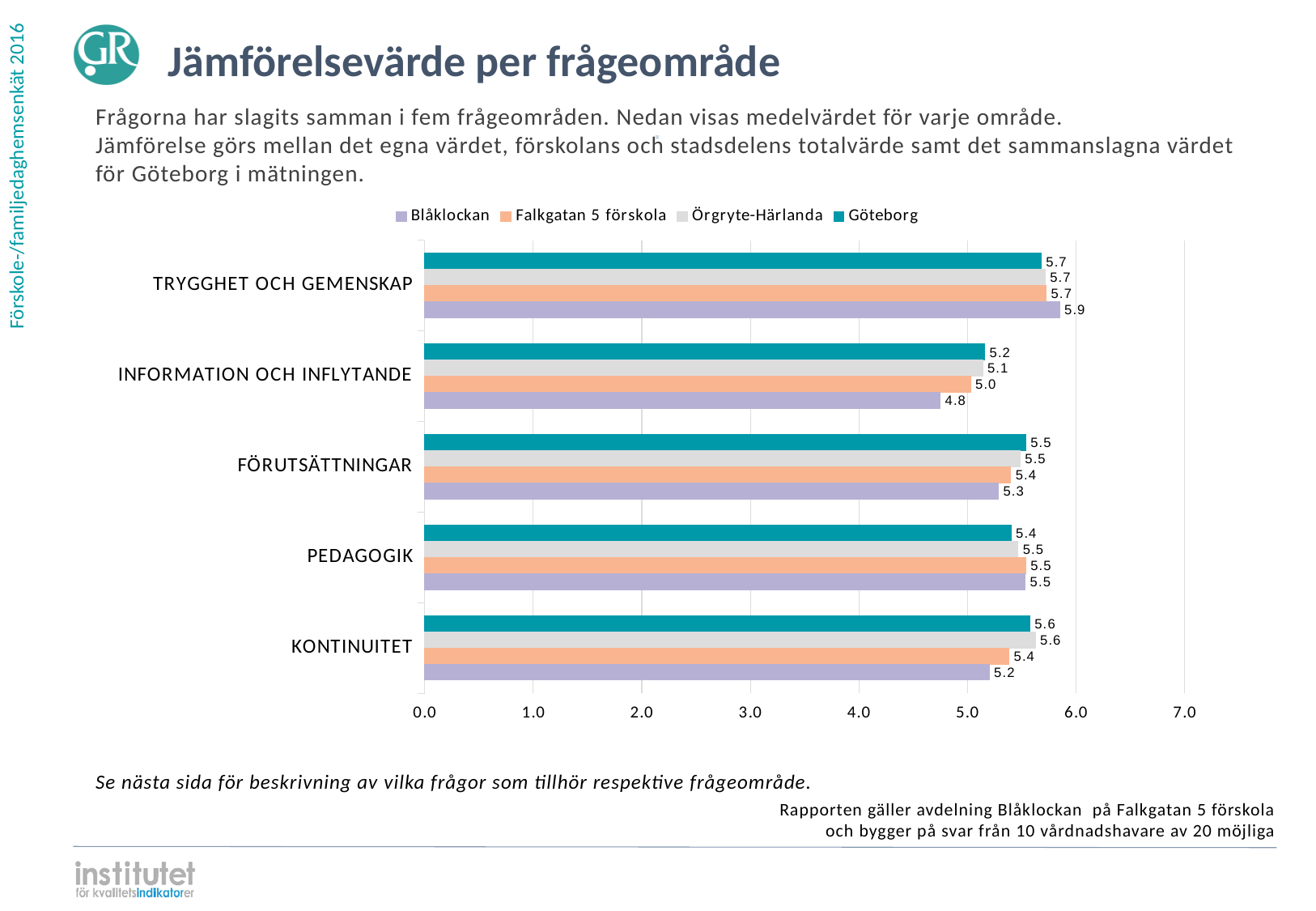
Which series is shown in teal in the legend? Göteborg What type of chart is shown on the slide? bar chart What is the value for Göteborg in INFORMATION OCH INFLYTANDE? 5.2 What is the difference between the Göteborg value and the Blåklockan value in KONTINUITET? 0.4 In which category does Blåklockan have its highest value? TRYGGHET OCH GEMENSKAP What is the value for Örgryte-Härlanda in PEDAGOGIK? 5.5 What is the value for Falkgatan 5 förskola in KONTINUITET? 5.4 How many series does the legend list? 4 In INFORMATION OCH INFLYTANDE, which is larger: the value for Göteborg or the value for Blåklockan? Göteborg How many question areas (categories) are shown on the chart? 5 What is the value for Blåklockan in TRYGGHET OCH GEMENSKAP? 5.9 In which category does Blåklockan have its lowest value? INFORMATION OCH INFLYTANDE